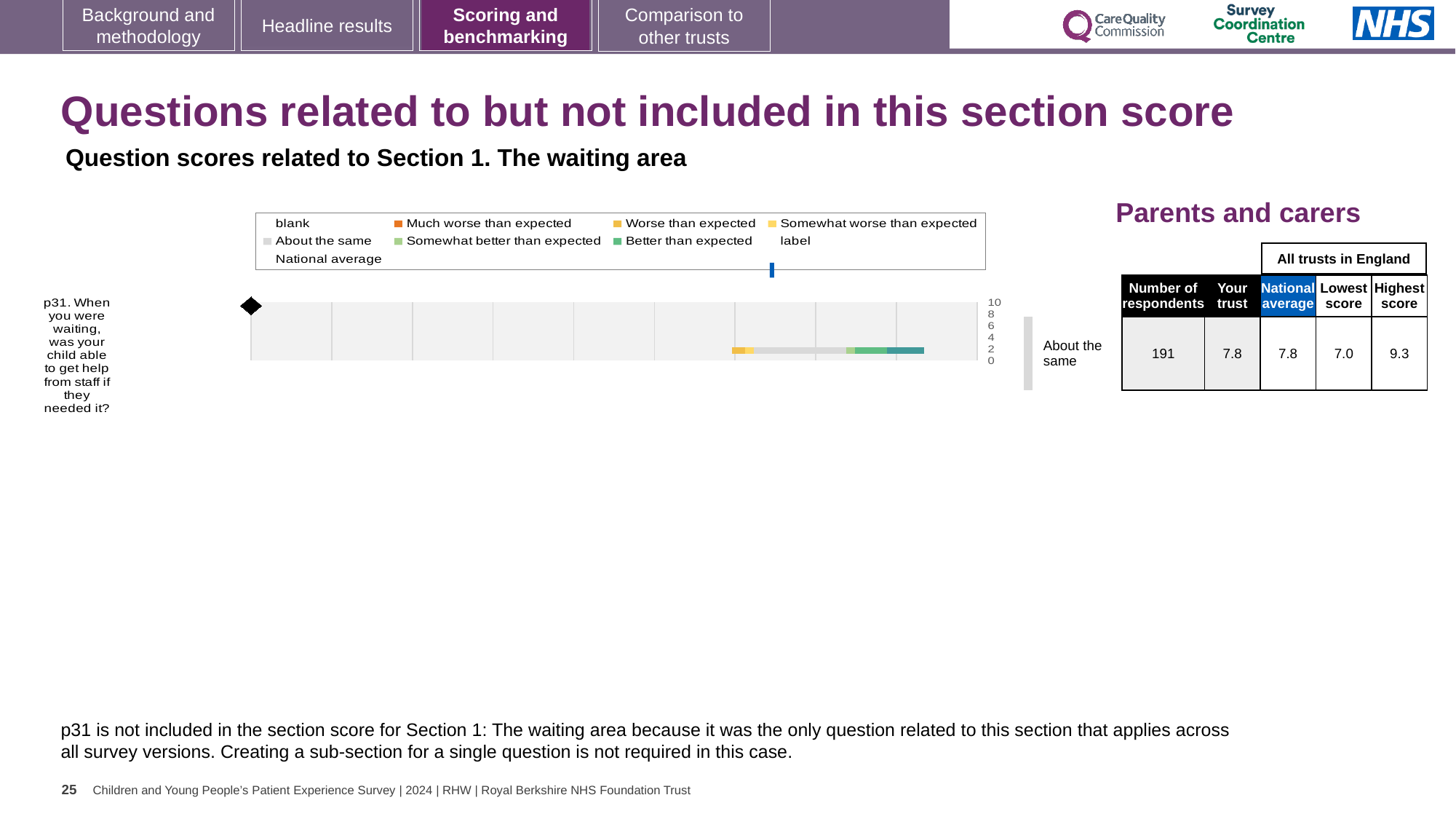
In the Parents and carers table, what is the 'Your trust' score for p31? 7.8 In the Parents and carers table, what is the lowest score among all trusts in England for p31? 7.0 What kind of chart is used to show the p31 question score? bar chart In the Parents and carers table, how many respondents answered p31? 191 Is the 'Your trust' score for p31 higher than, lower than, or the same as the national average? the same What category label is shown to the right of the p31 bar? About the same In the Parents and carers table, what is the highest score among all trusts in England for p31? 9.3 In the Parents and carers table, what is the national average score for p31? 7.8 Which question number is plotted in the chart? p31 How many entries does the chart legend list? 9 How many questions are plotted in the chart? 1 What is the difference between the highest score and the lowest score for p31 across all trusts in England? 2.3